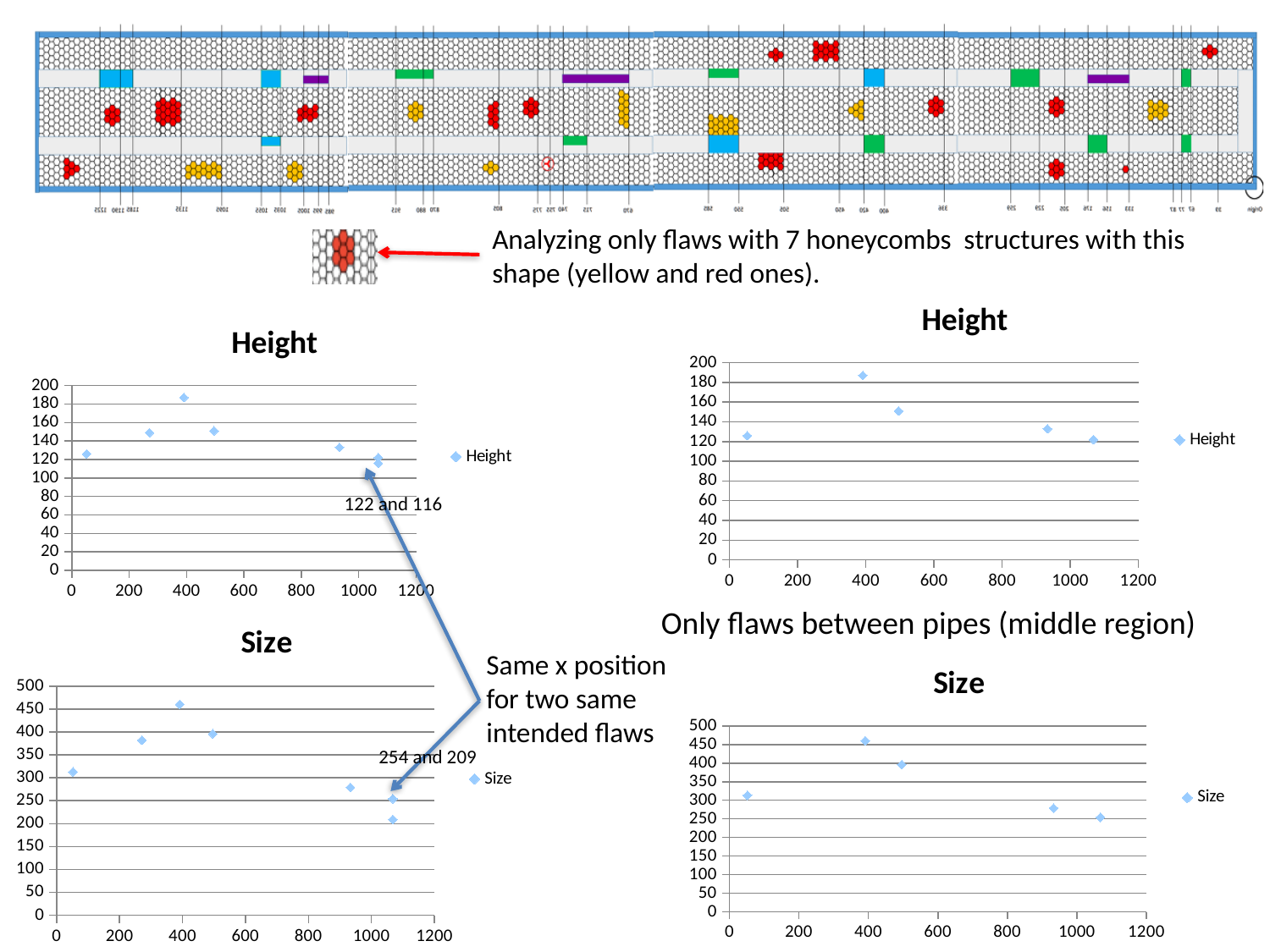
In the bottom-left "Size" chart, what are the two annotated values of the points sharing the same x position near 1070? 254 and 209 In the bottom-right "Size" chart, is the value of the point near x = 400 greater or less than 400? greater How many data points are plotted in the top-right "Height" chart? 5 In the top-left "Height" chart, what is the difference between the two annotated values 122 and 116? 6 In the bottom-left "Size" chart, what is the difference between the two annotated values 254 and 209? 45 In the top-left "Height" chart, what are the two annotated values of the points sharing the same x position near 1060? 122 and 116 What kind of chart is the top-left chart titled "Height"? scatter chart How many series does the legend of the bottom-left "Size" chart list? 1 What caption is written above the bottom-right "Size" chart? Only flaws between pipes (middle region) In the top-left "Height" chart, is the highest point greater or less than 180? greater How many data points are plotted in the top-left "Height" chart? 7 How many data points are plotted in the bottom-right "Size" chart? 5